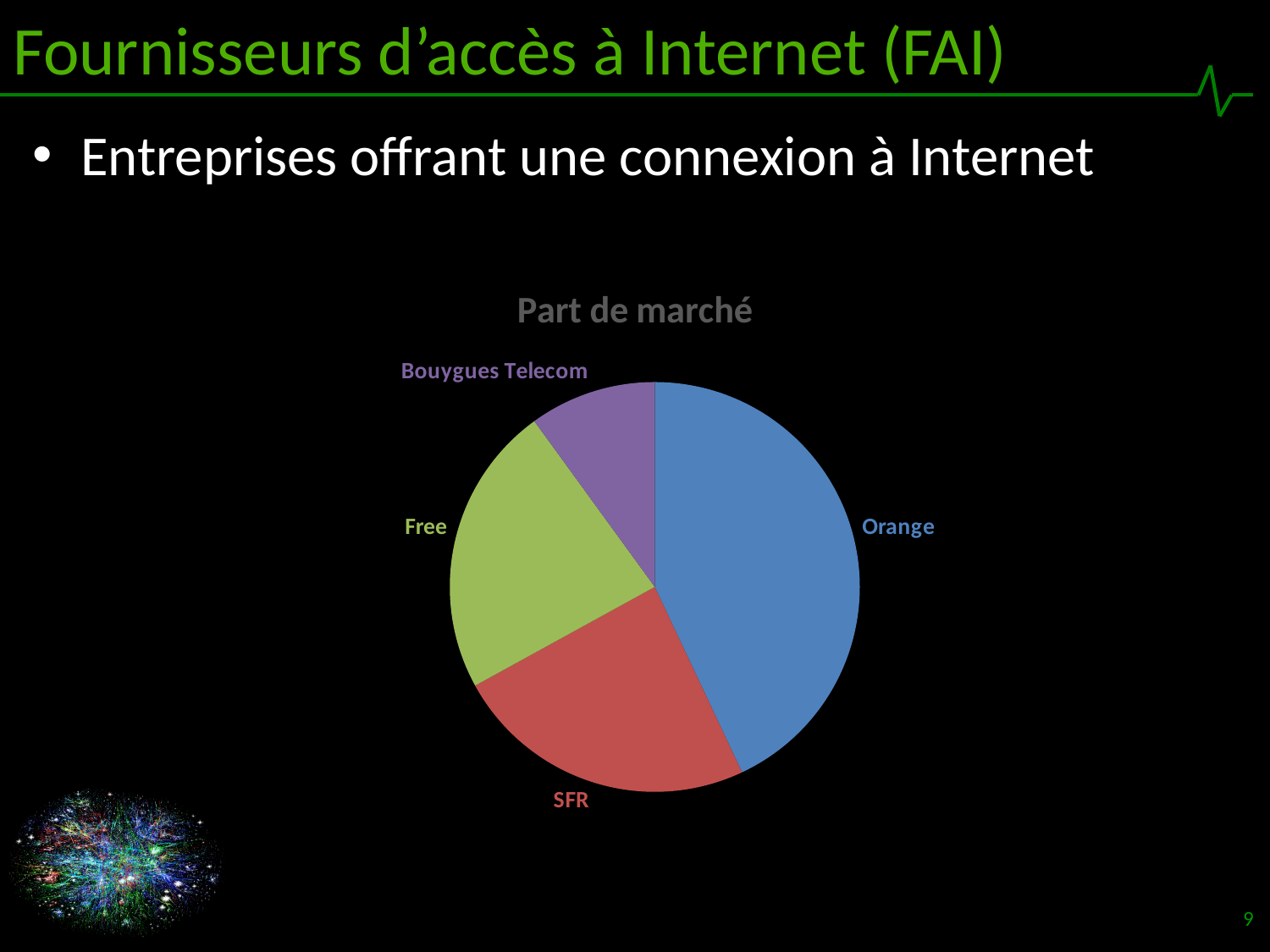
Which slice is larger, Orange or SFR? Orange Which category has the largest slice of the pie? Orange What colour is the Free slice of the pie chart? green What is the title of the chart? Part de marché Which slice is larger, SFR or Bouygues Telecom? SFR Which category has the smallest slice of the pie? Bouygues Telecom Which slice is larger, Free or Bouygues Telecom? Free What kind of chart is shown on the slide? pie chart How many slices does the pie chart have? 4